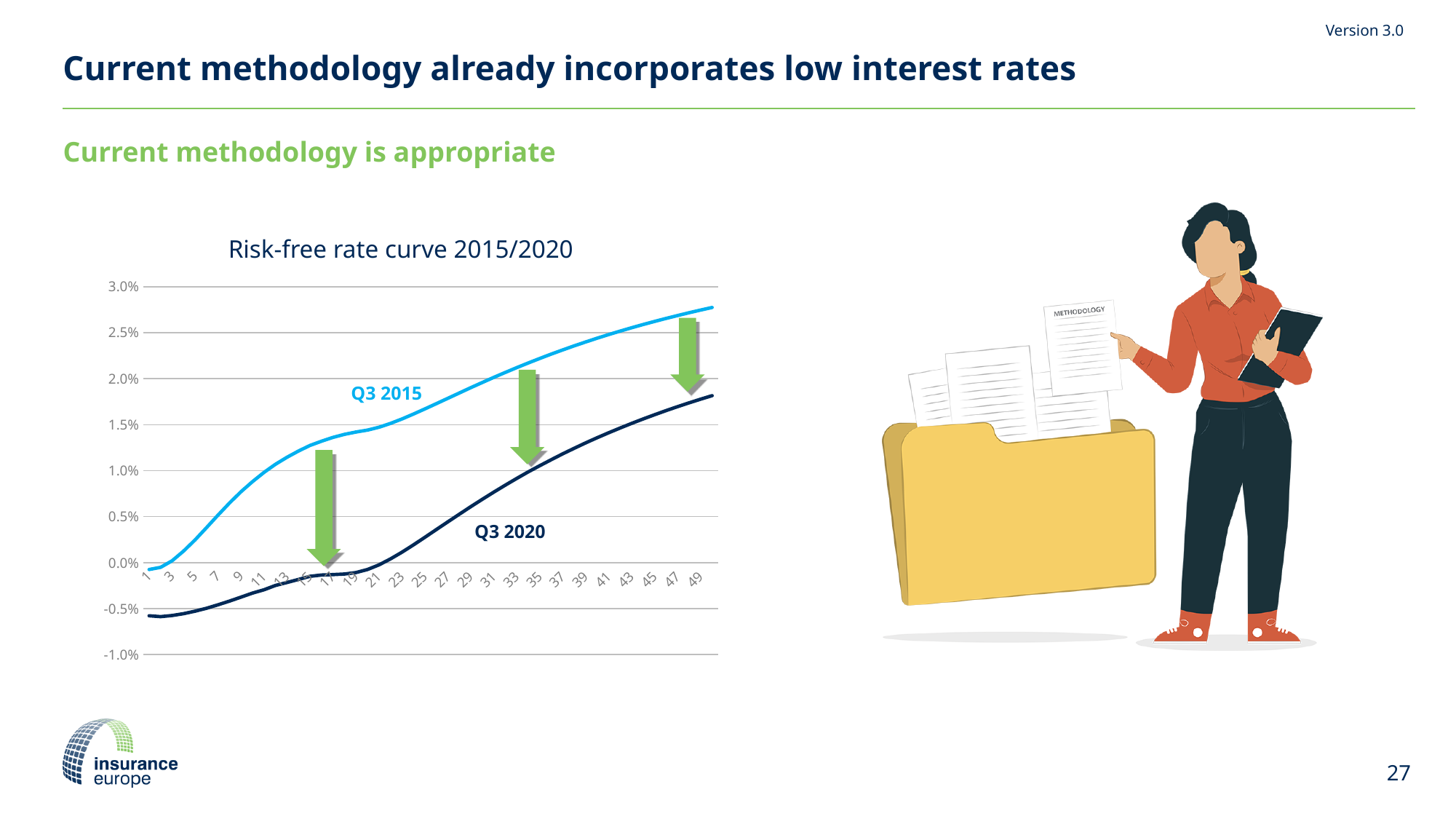
Is the value of the Q3 2020 curve at x = 49 greater or less than 2.0%? less How many tick labels are shown on the x axis? 25 Which series lies higher across the chart, Q3 2015 or Q3 2020? Q3 2015 Is the value of the Q3 2015 curve at x = 25 greater or less than 1.5%? greater What kind of chart is shown on the slide? line chart Do the values of the Q3 2020 curve rise or fall as you move along the x axis? rise Is the value of the Q3 2020 curve at x = 1 greater or less than 0.0%? less What is the highest value labelled on the y axis? 3.0% Do the values of the Q3 2015 curve rise or fall as you move along the x axis? rise What is the title of the chart? Risk-free rate curve 2015/2020 How many series are plotted in the chart? 2